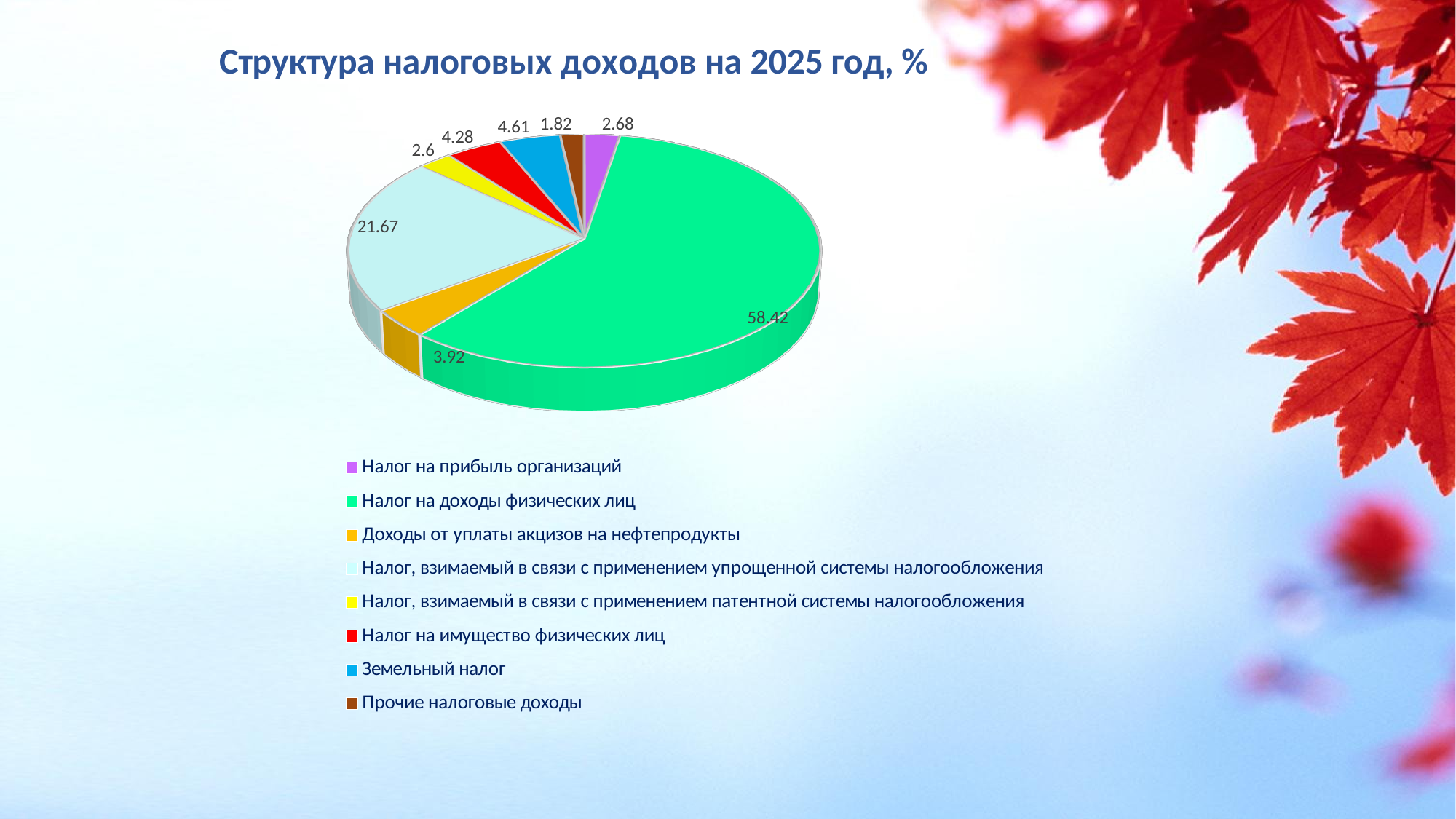
How many categories does the pie chart contain? 8 What value is shown for "Налог, взимаемый в связи с применением упрощенной системы налогообложения"? 21.67 What is the share of "Налог на доходы физических лиц" in the pie chart? 58.42 What value is shown for "Доходы от уплаты акцизов на нефтепродукты"? 3.92 What is the difference between the shares of "Налог на доходы физических лиц" and "Налог, взимаемый в связи с применением упрощенной системы налогообложения"? 36.75 What type of chart is shown on the slide? Pie chart Which is larger: the share of "Земельный налог" or the share of "Налог на имущество физических лиц"? Земельный налог What is the title of the chart? Структура налоговых доходов на 2025 год, % What value is shown for "Прочие налоговые доходы"? 1.82 Which category has the largest share in the pie chart? Налог на доходы физических лиц What value is shown for "Земельный налог"? 4.61 Which category has the smallest share in the pie chart? Прочие налоговые доходы